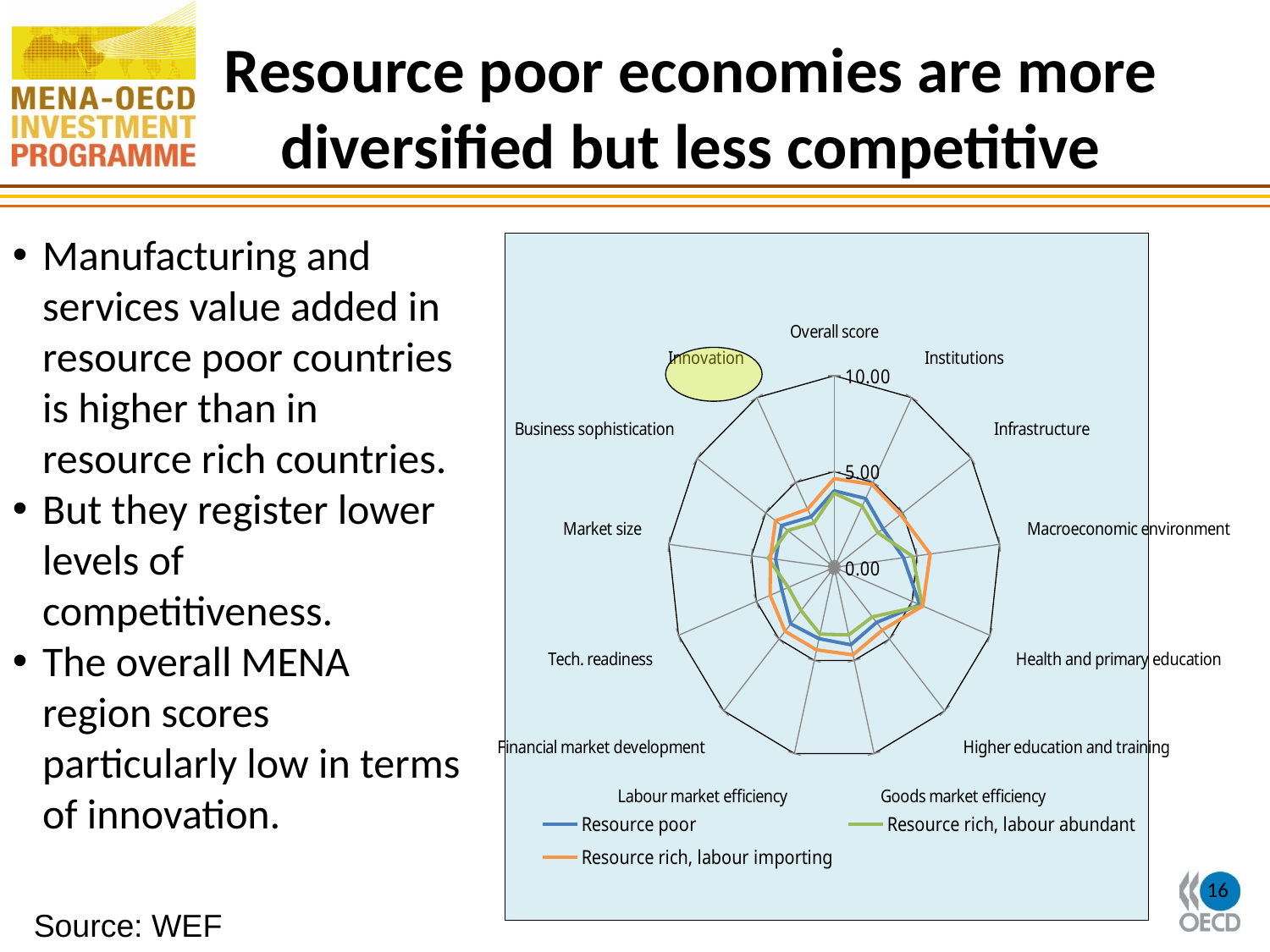
What kind of chart is shown on the slide? Radar chart How many category axes does the radar chart have? 13 Is the Institutions value for Resource rich, labour abundant greater or less than 5.00? less Which series is shown in green in the chart legend? Resource rich, labour abundant Is the Overall score for Resource poor greater or less than 5.00? less Is the Innovation value for Resource rich, labour importing greater or less than 5.00? less What is the maximum value shown on the radar chart's axis scale? 10.00 For Macroeconomic environment, which series has the larger value: Resource rich, labour importing or Resource rich, labour abundant? Resource rich, labour importing Which series is shown in orange in the chart legend? Resource rich, labour importing How many series does the chart's legend list? 3